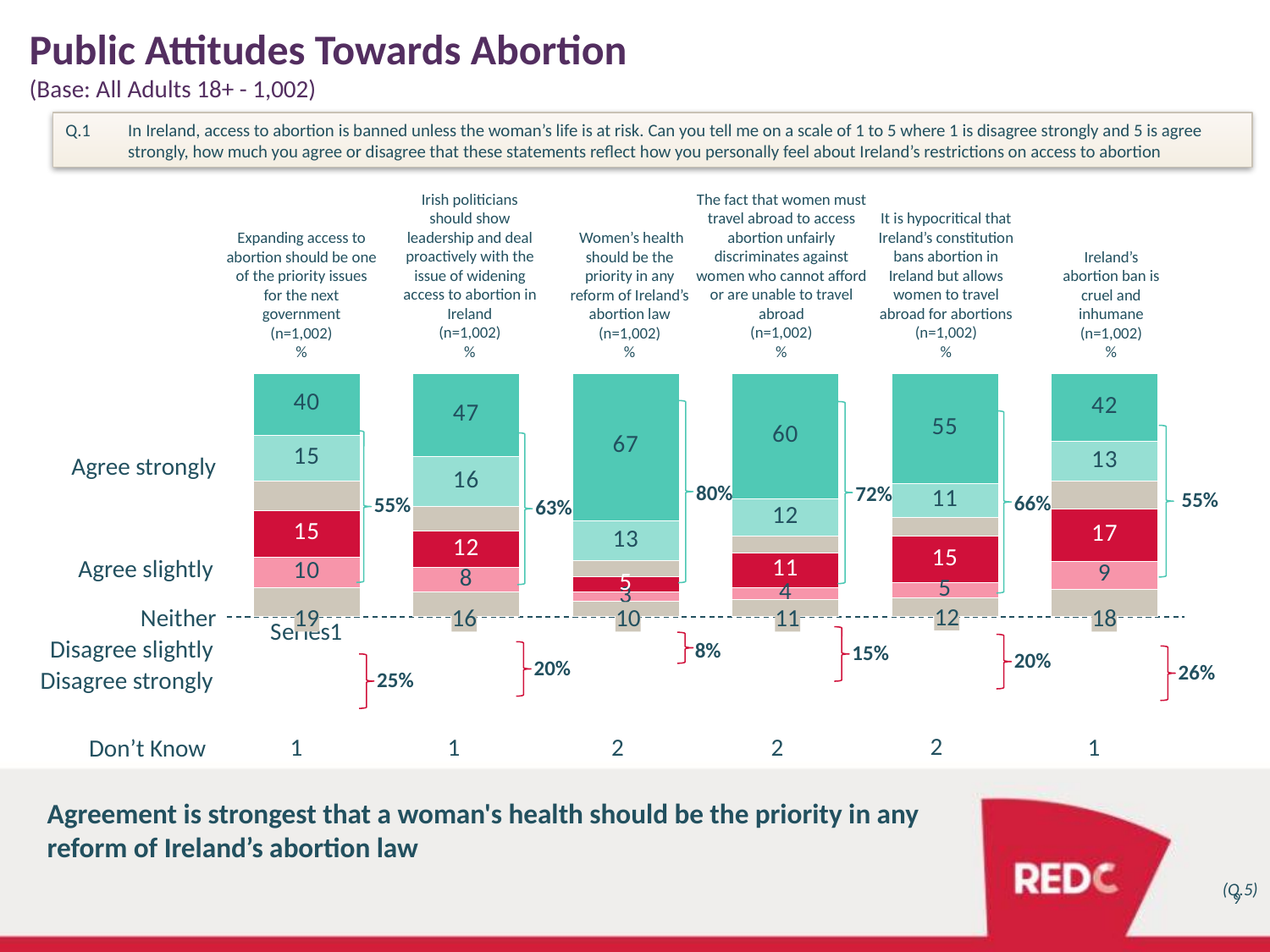
What is the difference between the 'Agree strongly' percentages for 'Women's health should be the priority' and 'Irish politicians should show leadership'? 20 What percentage agree strongly that expanding access to abortion should be one of the priority issues for the next government? 40 Which statement has the highest 'Agree strongly' percentage? Women's health should be the priority in any reform of Ireland's abortion law Which statement has the lowest 'Agree strongly' percentage? Expanding access to abortion should be one of the priority issues for the next government What is the total disagreement percentage shown for the statement that Ireland's abortion ban is cruel and inhumane? 26% What kind of chart is used on this slide? Stacked bar chart Which has a higher 'Agree strongly' percentage: 'It is hypocritical that Ireland's constitution bans abortion' or 'Ireland's abortion ban is cruel and inhumane'? It is hypocritical that Ireland's constitution bans abortion How many statements are shown in the chart? 6 What percentage agree strongly that women's health should be the priority in any reform of Ireland's abortion law? 67 What is the base size shown for each statement in the chart? n=1,002 What is the 'Don't Know' percentage for the statement that women's health should be the priority in any reform of Ireland's abortion law? 2 What is the total agreement percentage shown for the statement that women must travel abroad to access abortion unfairly discriminates against women who cannot afford or are unable to travel abroad? 72%